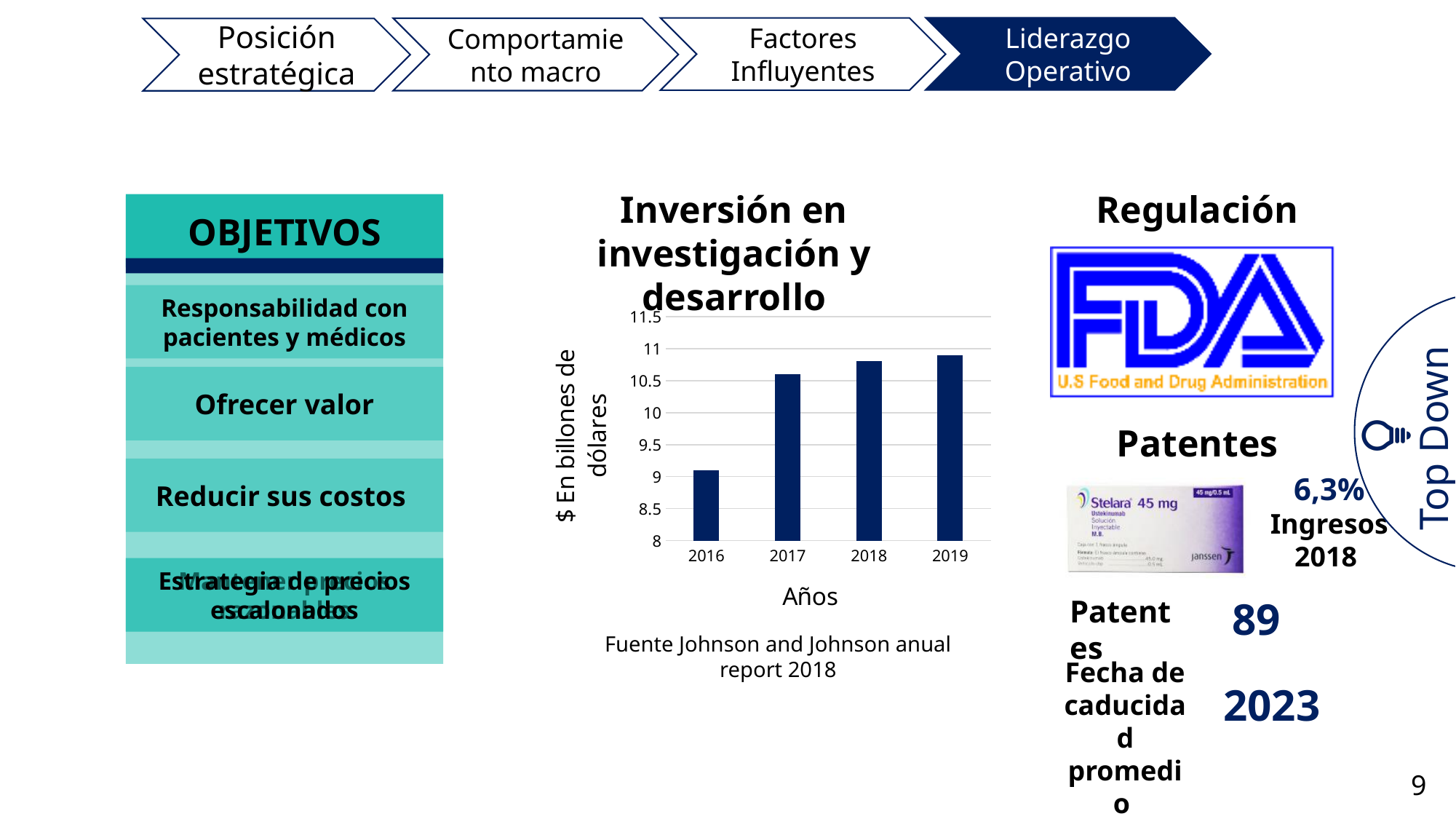
Is the value for 2018 greater or less than 10.5? greater How many years are plotted on the x axis of the chart? 4 Which is larger in the chart, the value for 2016 or the value for 2019? 2019 Is the value for 2017 greater or less than 10? greater Which is larger in the chart, the value for 2016 or the value for 2017? 2017 Is the value for 2019 greater or less than 10? greater What is the label of the x axis of the chart? Años What is the label of the y axis of the chart? $ En billones de dólares Do the values in the chart rise or fall from 2016 to 2019? rise What kind of chart is shown under the title 'Inversión en investigación y desarrollo'? bar chart Which year has the lowest bar in the chart? 2016